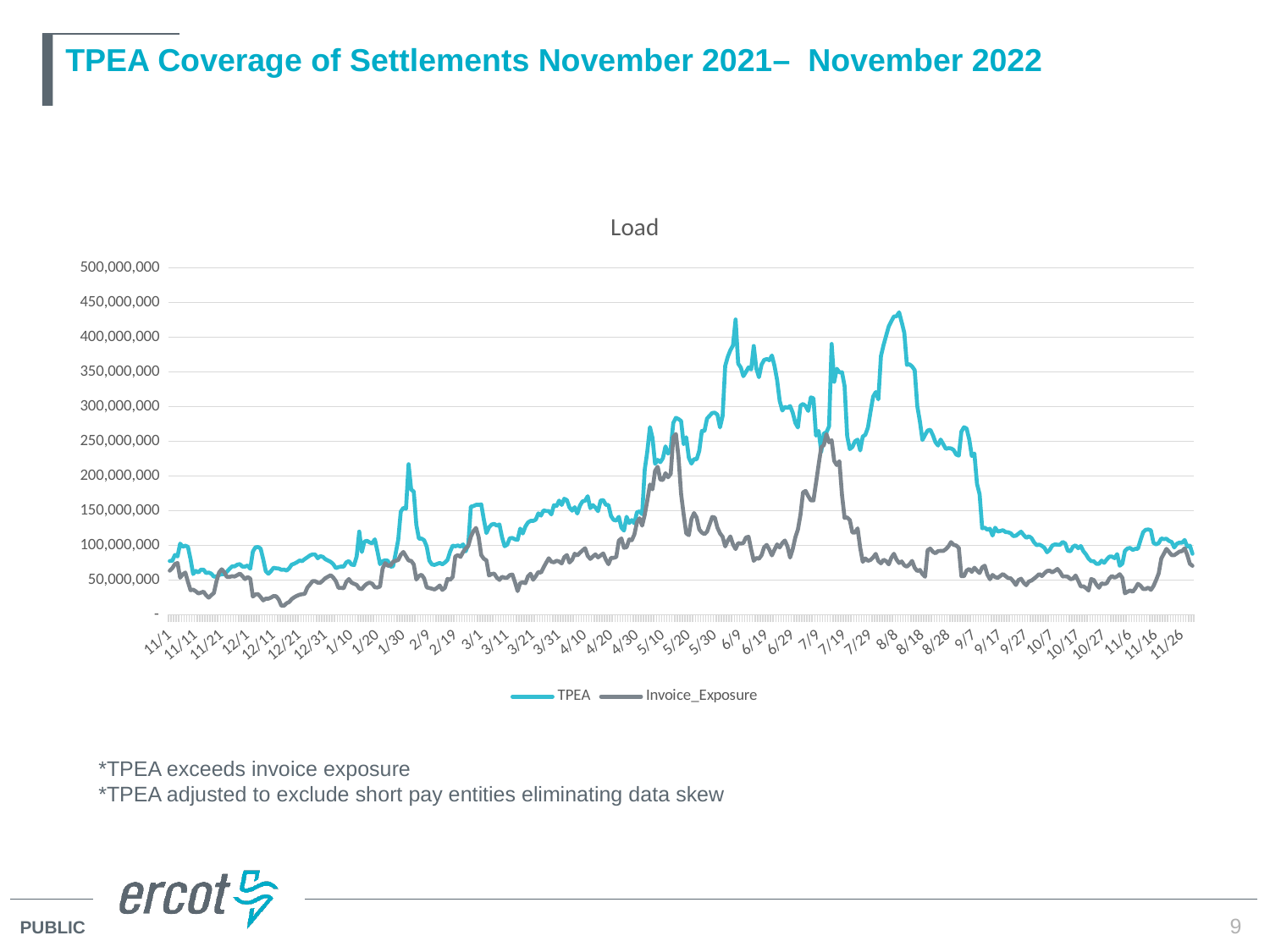
Is the value of the TPEA series around 2/9 greater or less than 100,000,000? less Is the peak value of the Invoice_Exposure series around 7/19 greater or less than 200,000,000? greater Does the TPEA series rise or fall between 4/30 and 6/9? rise Is the peak value of the TPEA series around 8/8 greater or less than 400,000,000? greater Which series reaches the highest value anywhere on the chart? TPEA What is the title shown above the chart? Load How many series does the legend list? 2 Around 8/8, which series has the larger value, TPEA or Invoice_Exposure? TPEA What are the two series named in the legend? TPEA and Invoice_Exposure What kind of chart is shown on the slide? line chart Does the TPEA series rise or fall between 8/8 and 9/17? fall